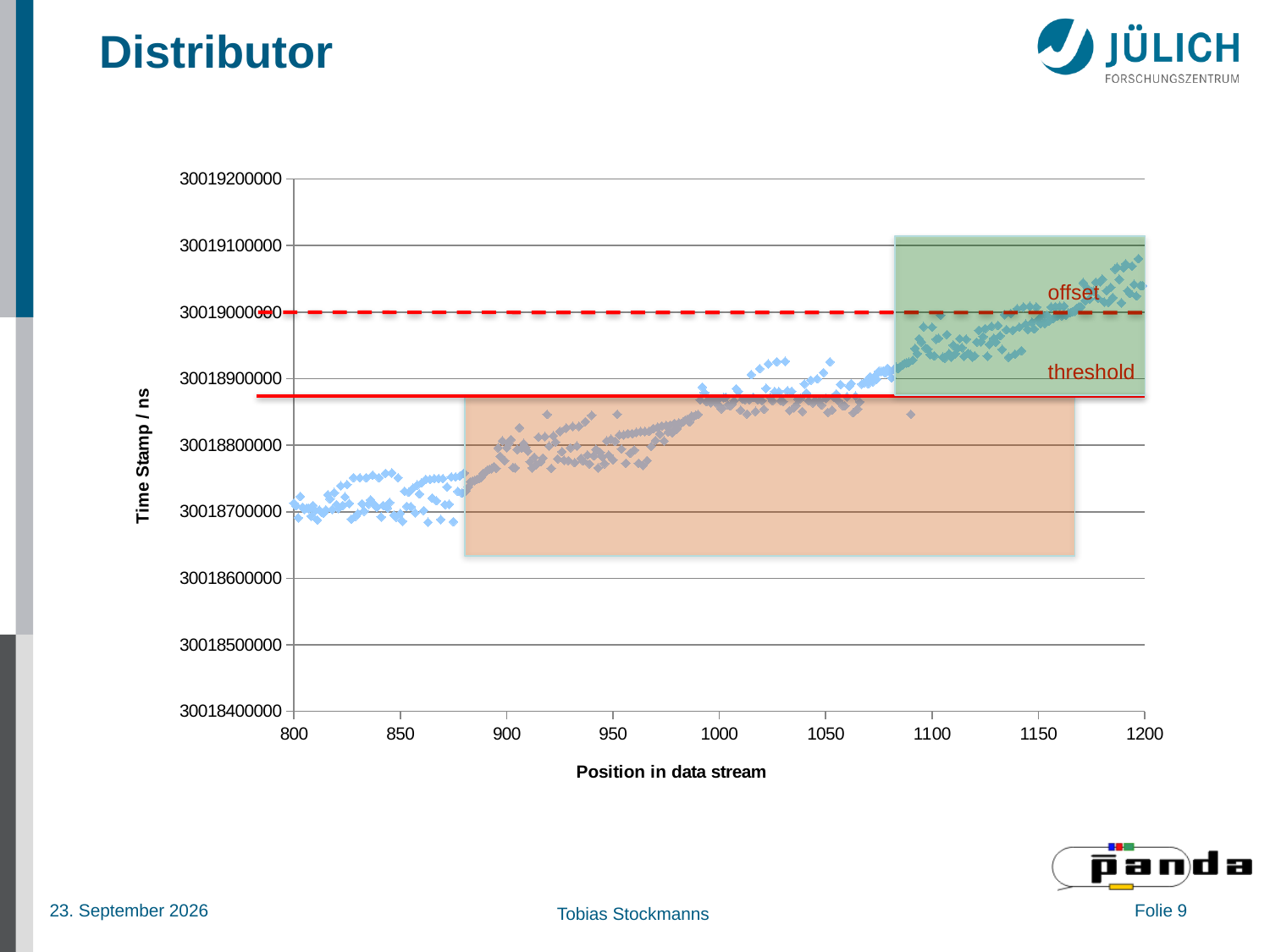
Is the time stamp value at position 1200 greater or less than 30019000000? greater What kind of chart is shown on the slide? scatter chart What is the title of the x axis of the chart? Position in data stream At which y-axis tick value is the dashed red line labelled 'offset' drawn? 30019000000 What is the highest value shown on the x axis of the chart? 1200 Is the time stamp value at position 1000 greater or less than 30018900000? less Is the time stamp value at position 800 greater or less than 30018800000? less Which has the larger time stamp value: the point at position 850 or the point at position 1150? position 1150 What is the lowest value shown on the y axis of the chart? 30018400000 Do the plotted time stamp values rise or fall as the position in the data stream increases from 800 to 1200? rise What is the title of the y axis of the chart? Time Stamp / ns